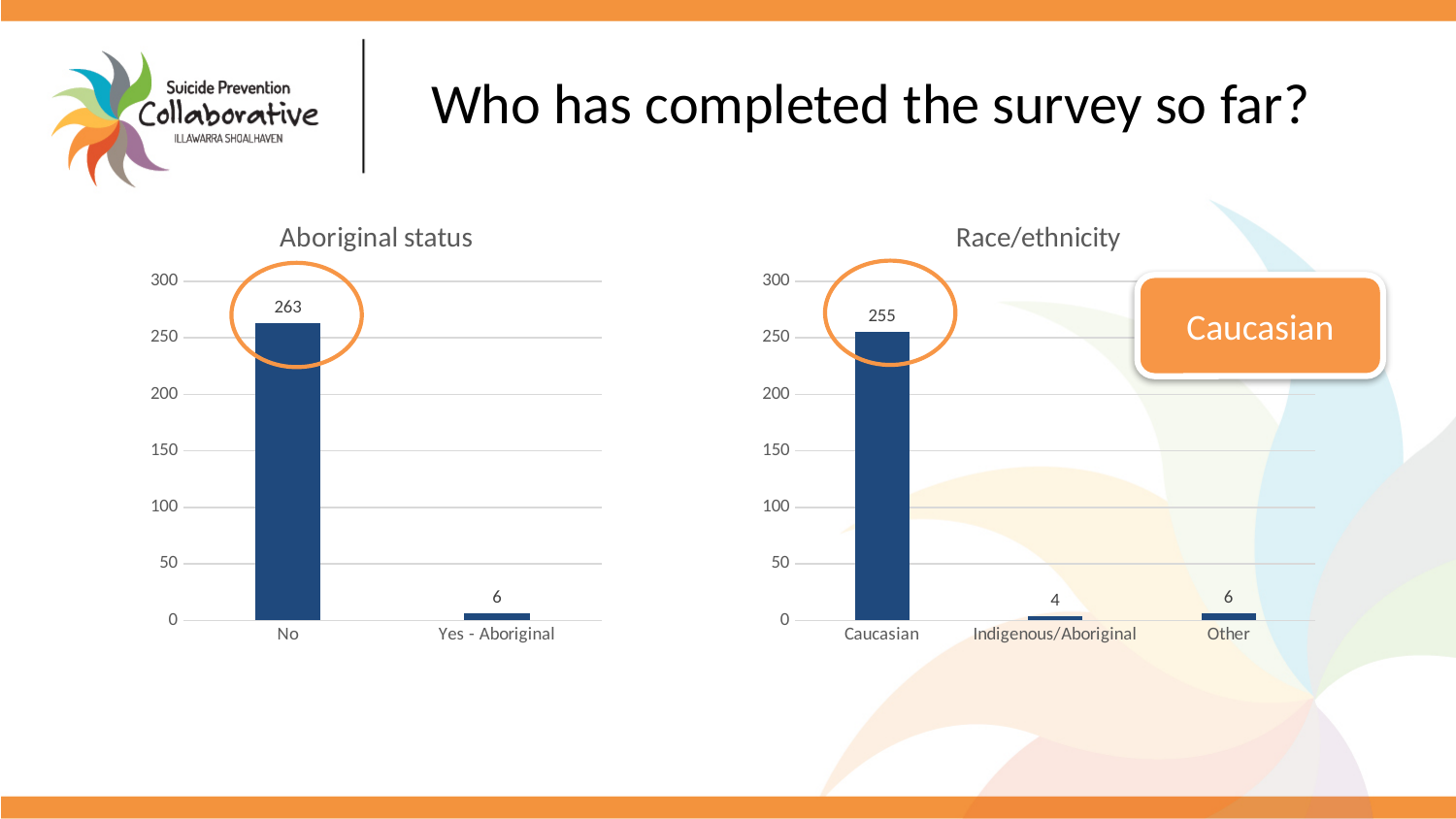
In the 'Aboriginal status' chart, is the value for 'No' greater or less than 250? greater In the 'Race/ethnicity' chart, which category has the highest value? Caucasian In the 'Race/ethnicity' chart, what is the value for 'Indigenous/Aboriginal'? 4 What type of chart is the 'Race/ethnicity' chart? Bar chart In the 'Race/ethnicity' chart, what is the value for 'Other'? 6 In the 'Aboriginal status' chart, what is the value for 'No'? 263 In the 'Aboriginal status' chart, what is the difference between the 'No' and 'Yes - Aboriginal' values? 257 In the 'Race/ethnicity' chart, what is the value for 'Caucasian'? 255 In the 'Race/ethnicity' chart, which category has the lowest value? Indigenous/Aboriginal In the 'Aboriginal status' chart, what is the value for 'Yes - Aboriginal'? 6 In the 'Race/ethnicity' chart, how many categories are shown on the x axis? 3 In the 'Aboriginal status' chart, how many categories are shown on the x axis? 2